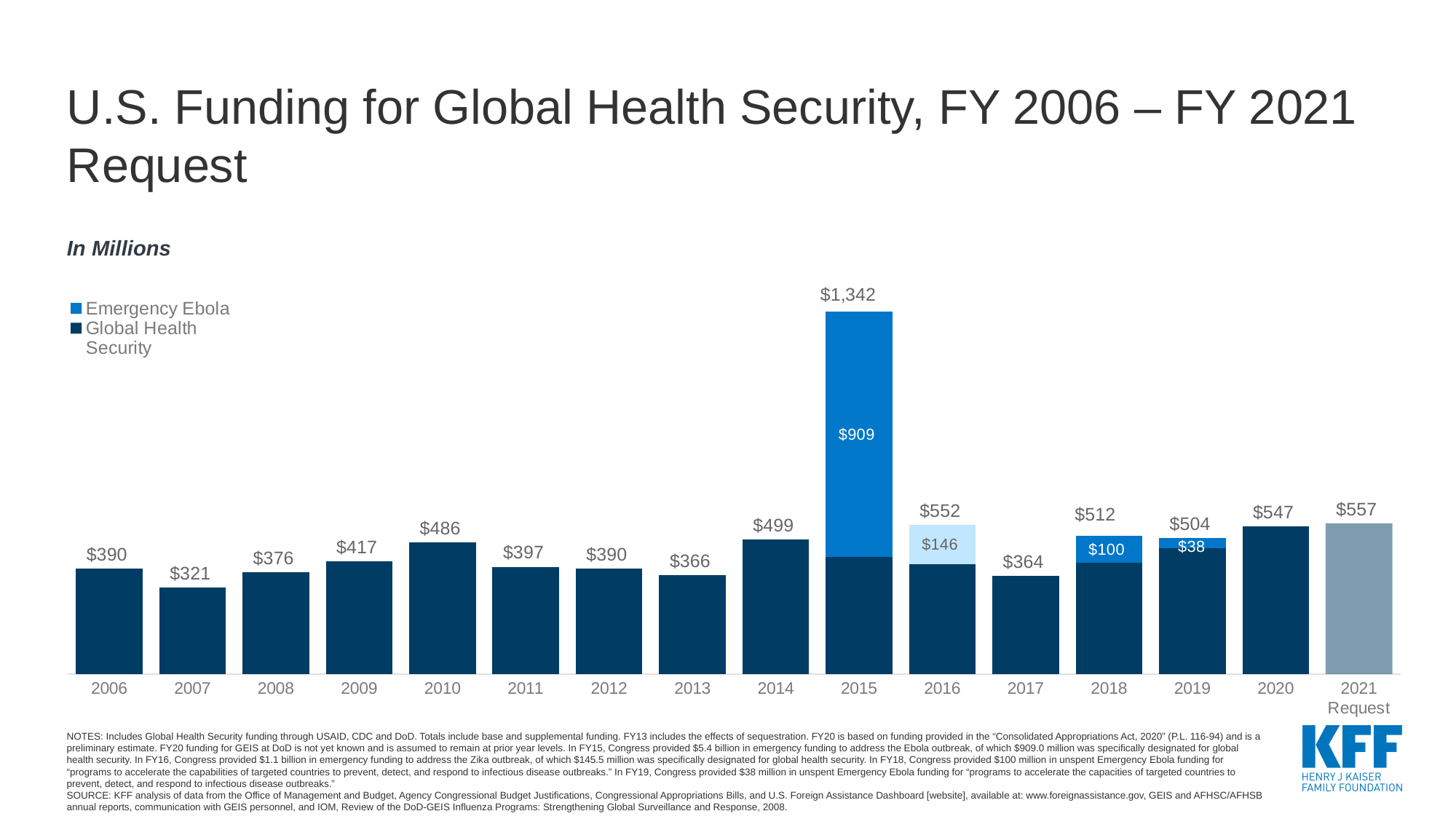
How many series does the legend list? 2 Which is larger, the total for 2010 or the total for 2014? 2014 What is the funding value shown for the 2021 Request? $557 What is the difference between the total for 2015 and the Emergency Ebola portion in 2015? $433 How many years (bars) are shown on the x axis? 16 Which year has the highest total funding? 2015 What unit is stated for the values in the chart? In Millions How much higher is the 2020 total than the 2019 total? $43 Which year has the lowest total funding? 2007 What type of chart is shown on the slide? Stacked bar chart What is the total U.S. funding for global health security in FY 2015? $1,342